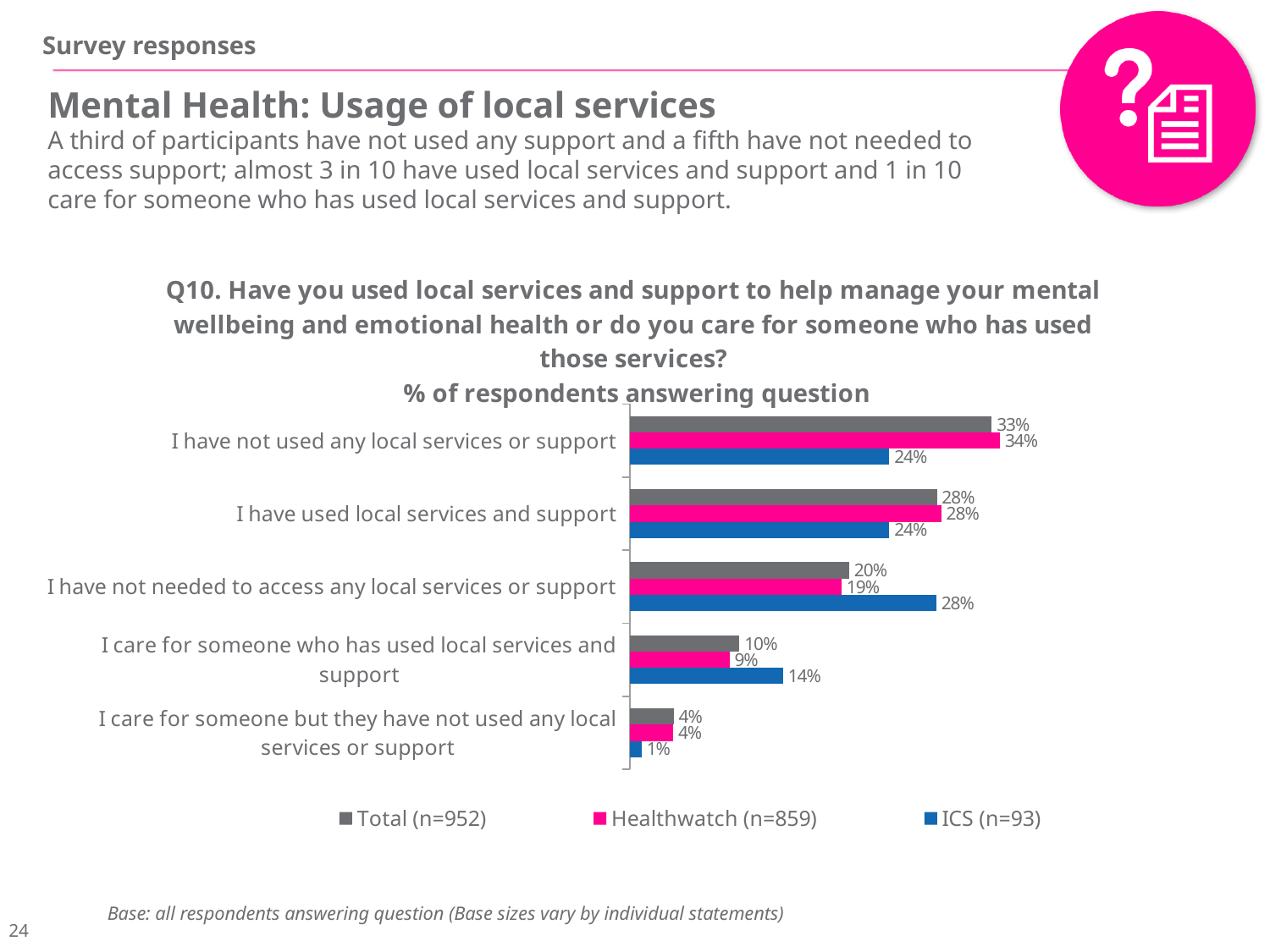
How many series does the legend list? 3 Which category has the lowest ICS (n=93) value? I care for someone but they have not used any local services or support What is the difference between the Total (n=952) and Healthwatch (n=859) values for 'I have not needed to access any local services or support'? 1% What is the Total (n=952) value for 'I have not used any local services or support'? 33% What is the ICS (n=93) value for 'I have not needed to access any local services or support'? 28% What is the Healthwatch (n=859) value for 'I care for someone who has used local services and support'? 9% Which category has the highest Healthwatch (n=859) value? I have not used any local services or support For 'I care for someone who has used local services and support', which is larger: the Total (n=952) value or the ICS (n=93) value? ICS (n=93) Which colour represents the ICS (n=93) series in the chart? Blue How many response categories are shown on the chart? 5 What is the difference between the Healthwatch (n=859) and ICS (n=93) values for 'I have not used any local services or support'? 10% What kind of chart is shown on the slide? Bar chart